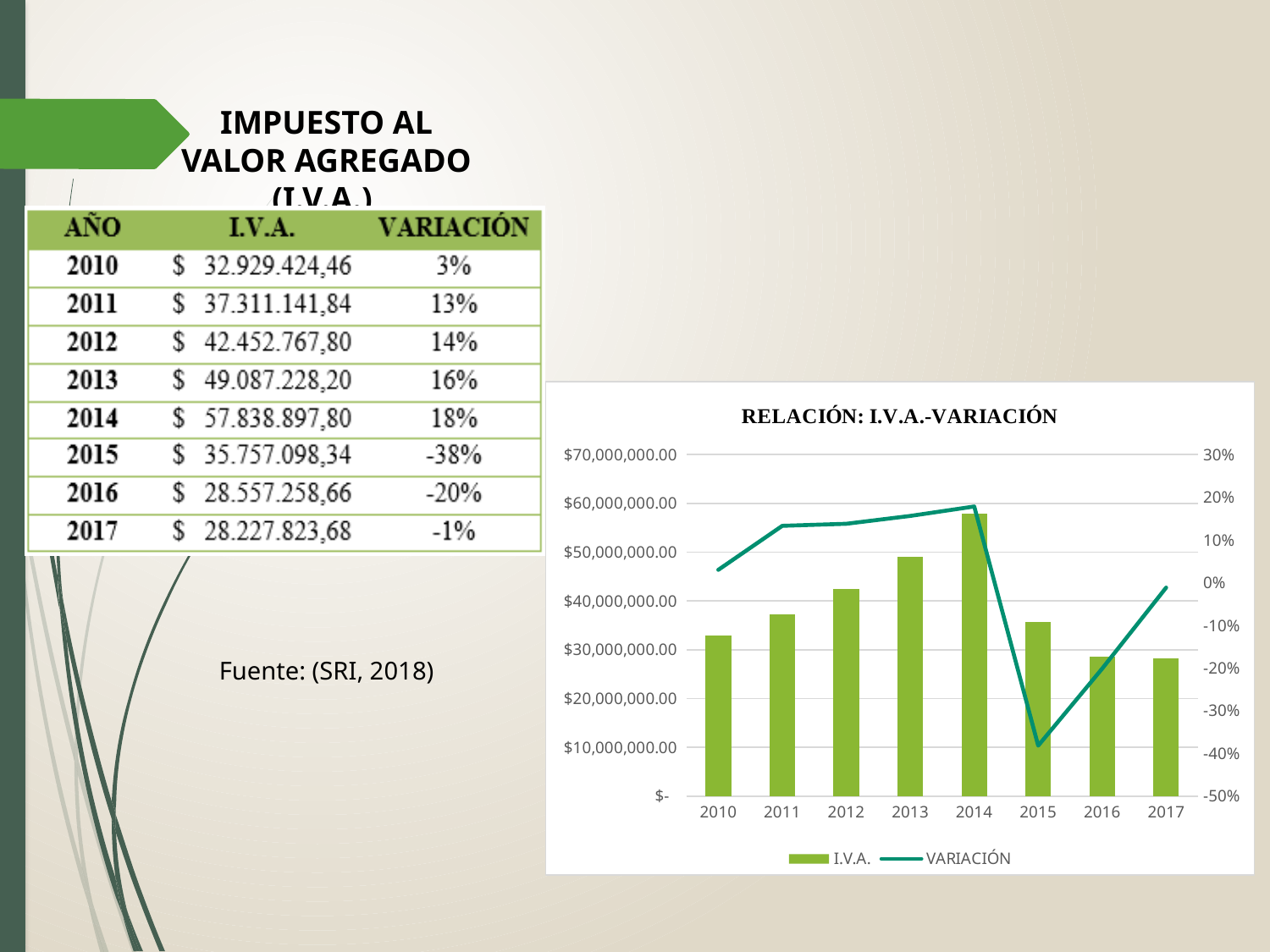
In the RELACIÓN: I.V.A.-VARIACIÓN chart, which year has the tallest I.V.A. bar? 2014 In the RELACIÓN: I.V.A.-VARIACIÓN chart, which year has the larger I.V.A. bar, 2013 or 2015? 2013 What are the two legend entries of the RELACIÓN: I.V.A.-VARIACIÓN chart? I.V.A. and VARIACIÓN In the RELACIÓN: I.V.A.-VARIACIÓN chart, is the I.V.A. bar for 2010 greater or less than $40,000,000.00? less How many years are plotted along the x axis of the RELACIÓN: I.V.A.-VARIACIÓN chart? 8 In the RELACIÓN: I.V.A.-VARIACIÓN chart, do the I.V.A. bars rise or fall from 2010 to 2014? rise In the RELACIÓN: I.V.A.-VARIACIÓN chart, which year has the lowest point on the VARIACIÓN line? 2015 How many series does the legend of the RELACIÓN: I.V.A.-VARIACIÓN chart list? 2 What kind of chart is shown under the title RELACIÓN: I.V.A.-VARIACIÓN? A bar chart combined with a line According to the slide, what is the I.V.A. value for 2014? $ 57.838.897,80 According to the slide, what is the VARIACIÓN value for 2015? -38% In the RELACIÓN: I.V.A.-VARIACIÓN chart, is the I.V.A. bar for 2014 greater or less than $50,000,000.00? greater